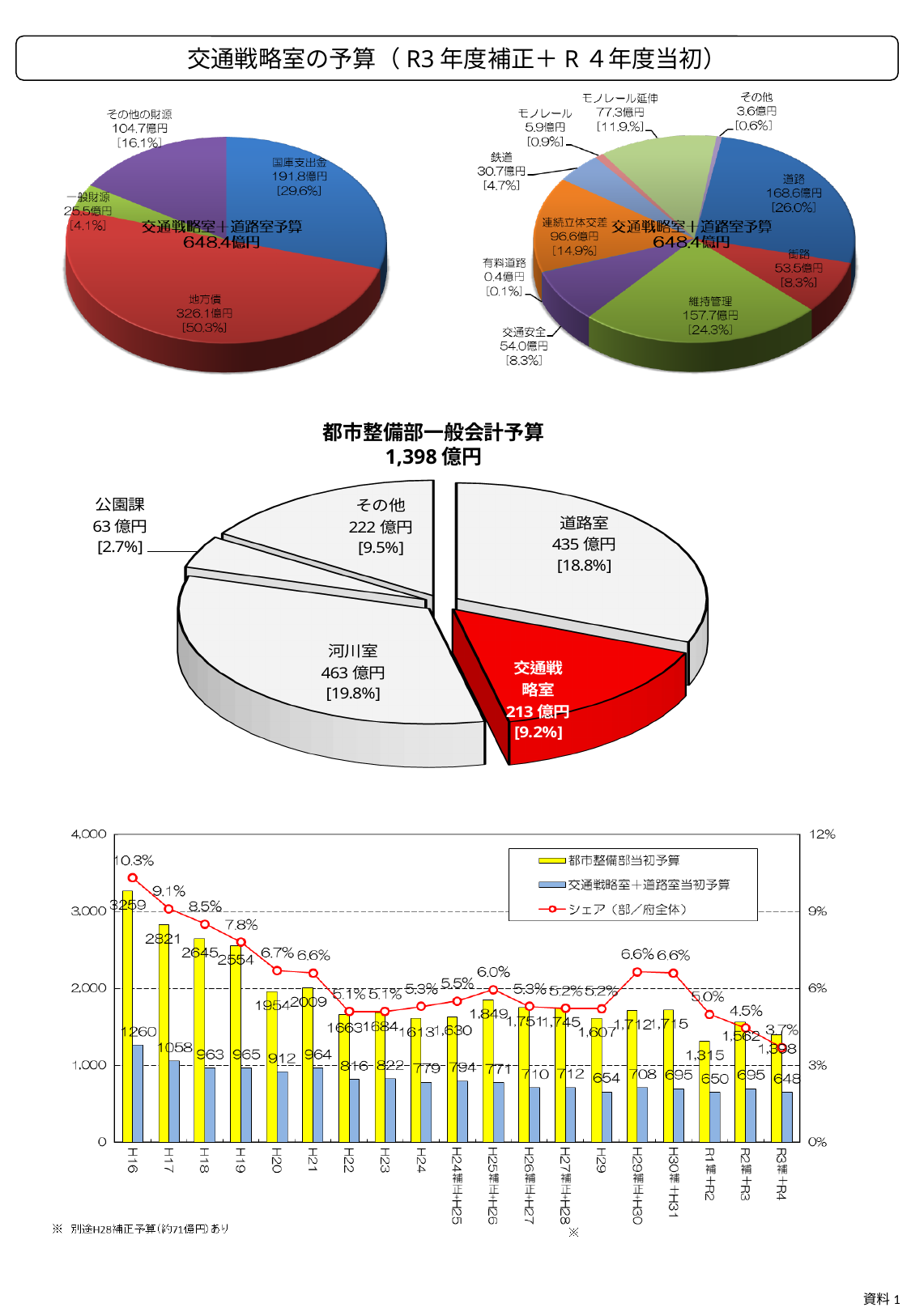
In the bottom chart, what is the シェア（部／府全体） value for R3補+R4? 3.7% In the middle pie chart (都市整備部一般会計予算 1,398億円), what is the value for 交通戦略室? 213億円 In the top-right pie chart (交通戦略室＋道路室予算 648.4億円), what is the value for 連続立体交差? 96.6億円 In the top-right pie chart (交通戦略室＋道路室予算 648.4億円), which category has the smallest value? 有料道路 In the top-right pie chart (交通戦略室＋道路室予算 648.4億円), which category has the largest value? 道路 In the top-left pie chart (交通戦略室＋道路室予算 648.4億円), what share of the pie does 国庫支出金 represent? 29.6% In the middle pie chart (都市整備部一般会計予算 1,398億円), what is the difference between 河川室 and 道路室? 28億円 In the bottom chart, is the value of 交通戦略室＋道路室当初予算 for H17 larger or smaller than for H18? larger In the bottom chart, how many series does the legend list? 3 In the bottom chart, what is the value of 都市整備部当初予算 for H16? 3259 In the middle pie chart (都市整備部一般会計予算 1,398億円), how many slices are there? 5 In the top-left pie chart (交通戦略室＋道路室予算 648.4億円), what is the value for 地方債? 326.1億円